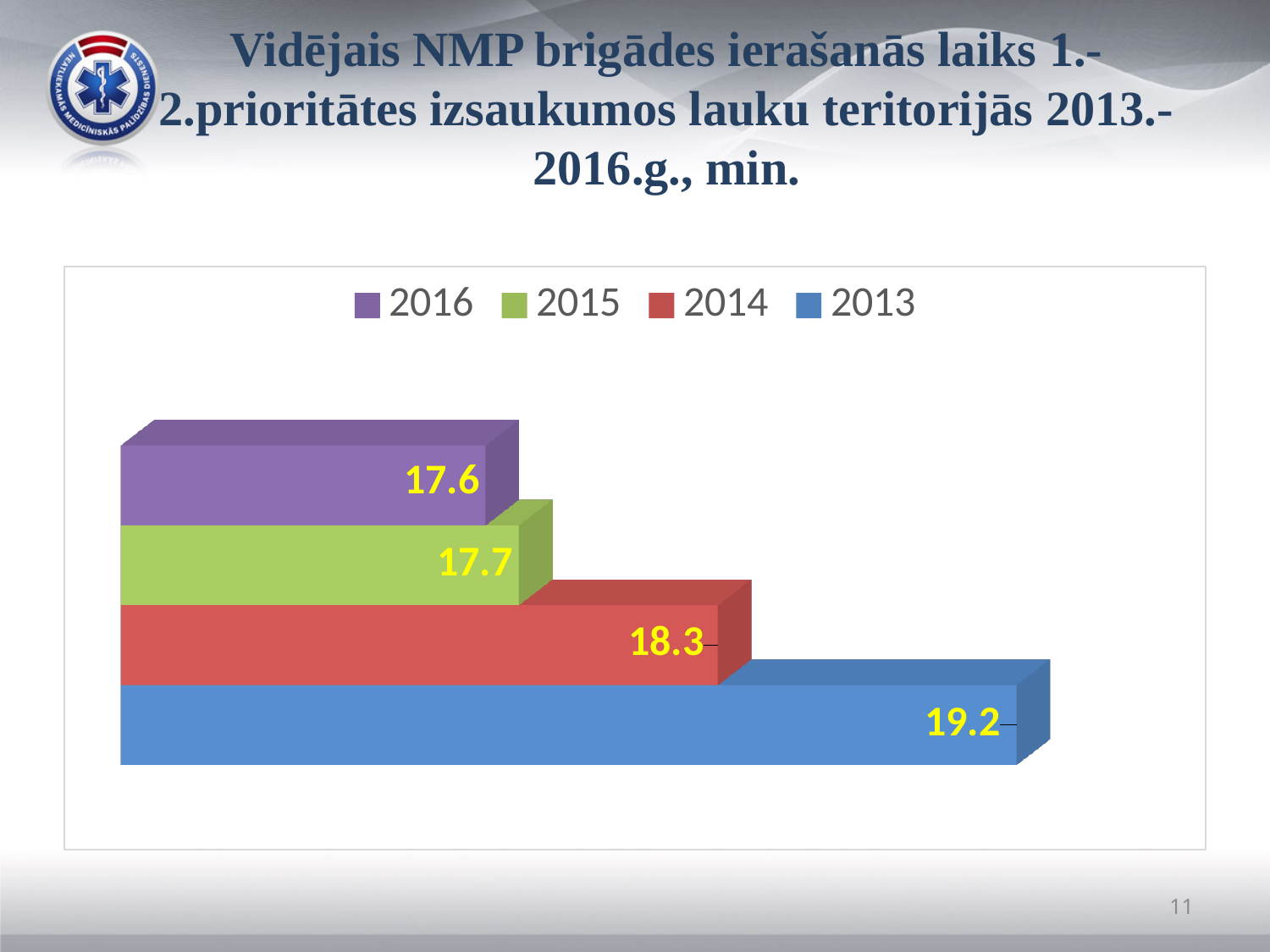
What is the value for 2013? 19.2 What is the value for 2014? 18.3 Which colour represents 2015 in the legend? green What is the value for 2016? 17.6 What is the difference between the values for 2013 and 2016? 1.6 What is the difference between the values for 2014 and 2015? 0.6 How many series does the legend list? 4 What kind of chart is shown on the slide? bar chart Which year has the highest value? 2013 What is the value for 2015? 17.7 Which year has the lowest value? 2016 Which is larger, the value for 2014 or the value for 2016? 2014